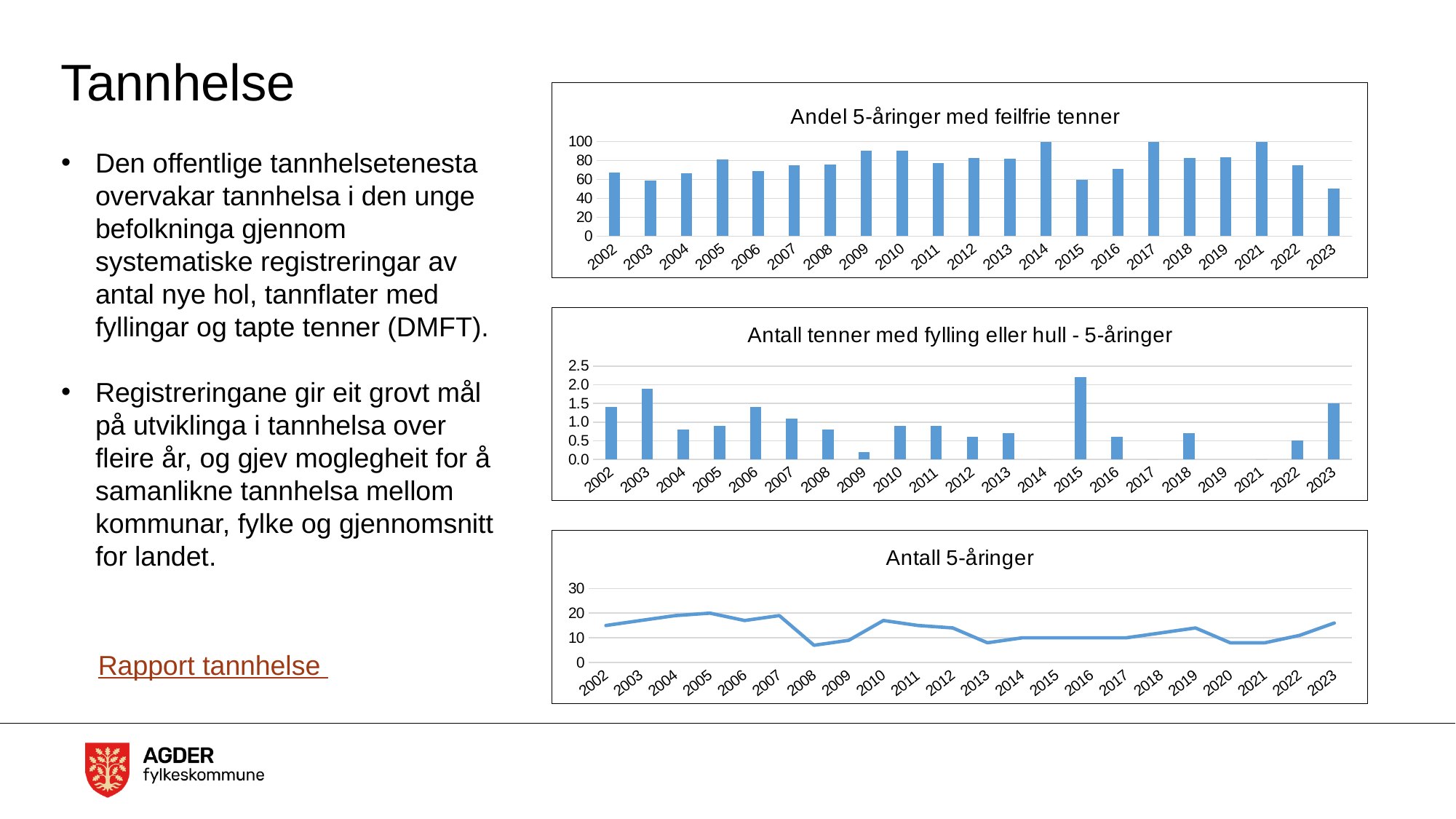
In the 'Antall 5-åringer' chart, is the value for 2008 greater or less than 10? less In the 'Andel 5-åringer med feilfrie tenner' chart, which year has the lowest bar? 2023 In the 'Andel 5-åringer med feilfrie tenner' chart, is the value for 2023 greater or less than 60? less In the 'Andel 5-åringer med feilfrie tenner' chart, how many years are shown on the x axis? 21 In the 'Andel 5-åringer med feilfrie tenner' chart, which is larger, the value for 2014 or the value for 2023? 2014 In the 'Antall tenner med fylling eller hull - 5-åringer' chart, which year has the tallest bar? 2015 In the 'Antall 5-åringer' chart, how many years are shown on the x axis? 22 In the 'Antall tenner med fylling eller hull - 5-åringer' chart, which is larger, the value for 2003 or the value for 2004? 2003 What kind of chart is the 'Andel 5-åringer med feilfrie tenner' chart? bar chart In the 'Antall tenner med fylling eller hull - 5-åringer' chart, is the value for 2015 greater or less than 2.0? greater What kind of chart is the 'Antall 5-åringer' chart? line chart